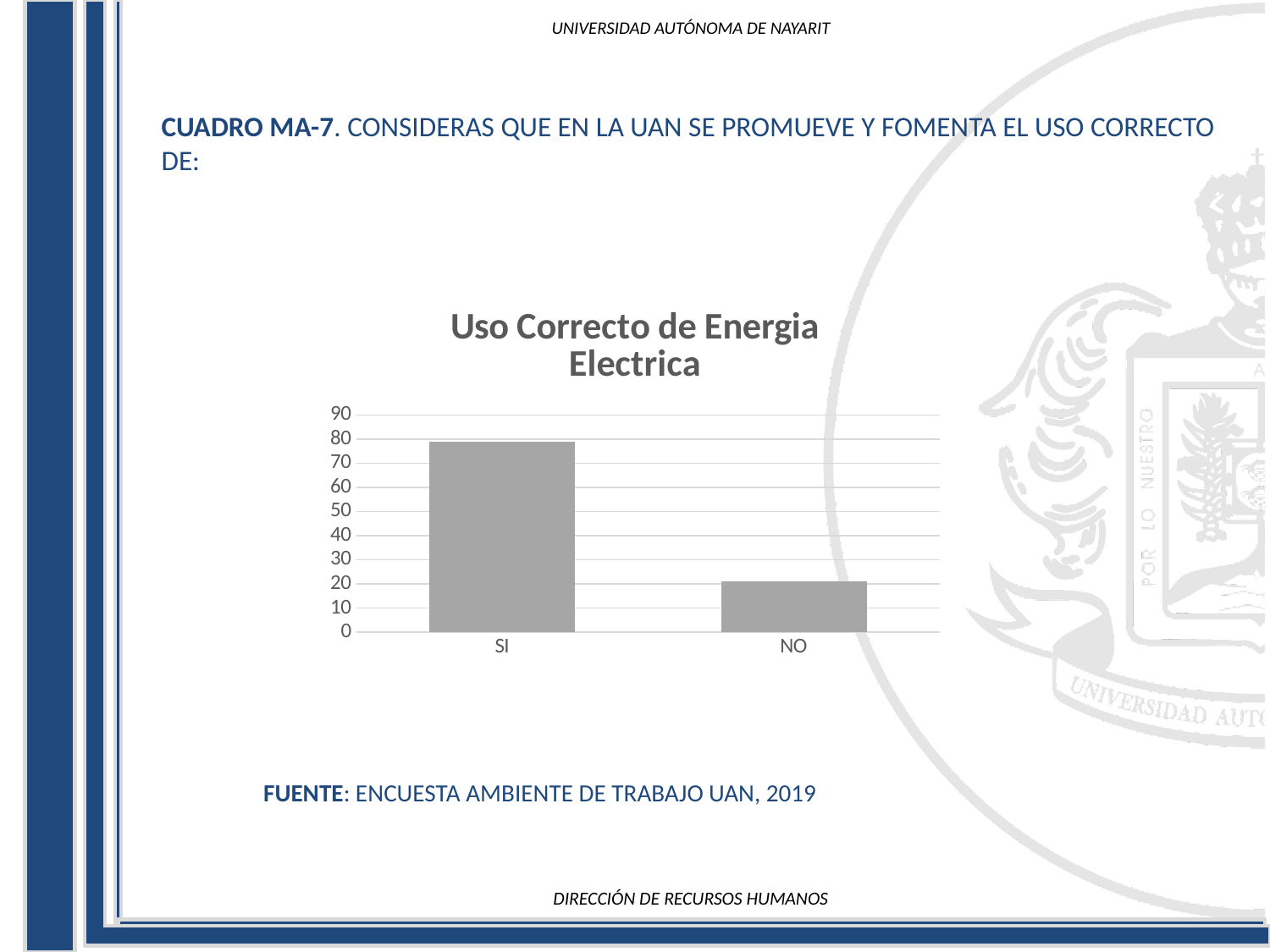
Which is larger, the value for SI or the value for NO? SI Is the value for SI greater or less than 70? greater What kind of chart is shown on the slide? bar chart How many categories are shown on the x axis of the chart? 2 Is the value for SI greater or less than 90? less What is the highest value shown on the vertical axis of the chart? 90 Do the values rise or fall from SI to NO along the x axis? fall Is the value for NO greater or less than 30? less Which category has the lowest value in the chart? NO What is the title of the chart? Uso Correcto de Energia Electrica Which category has the highest value in the chart? SI